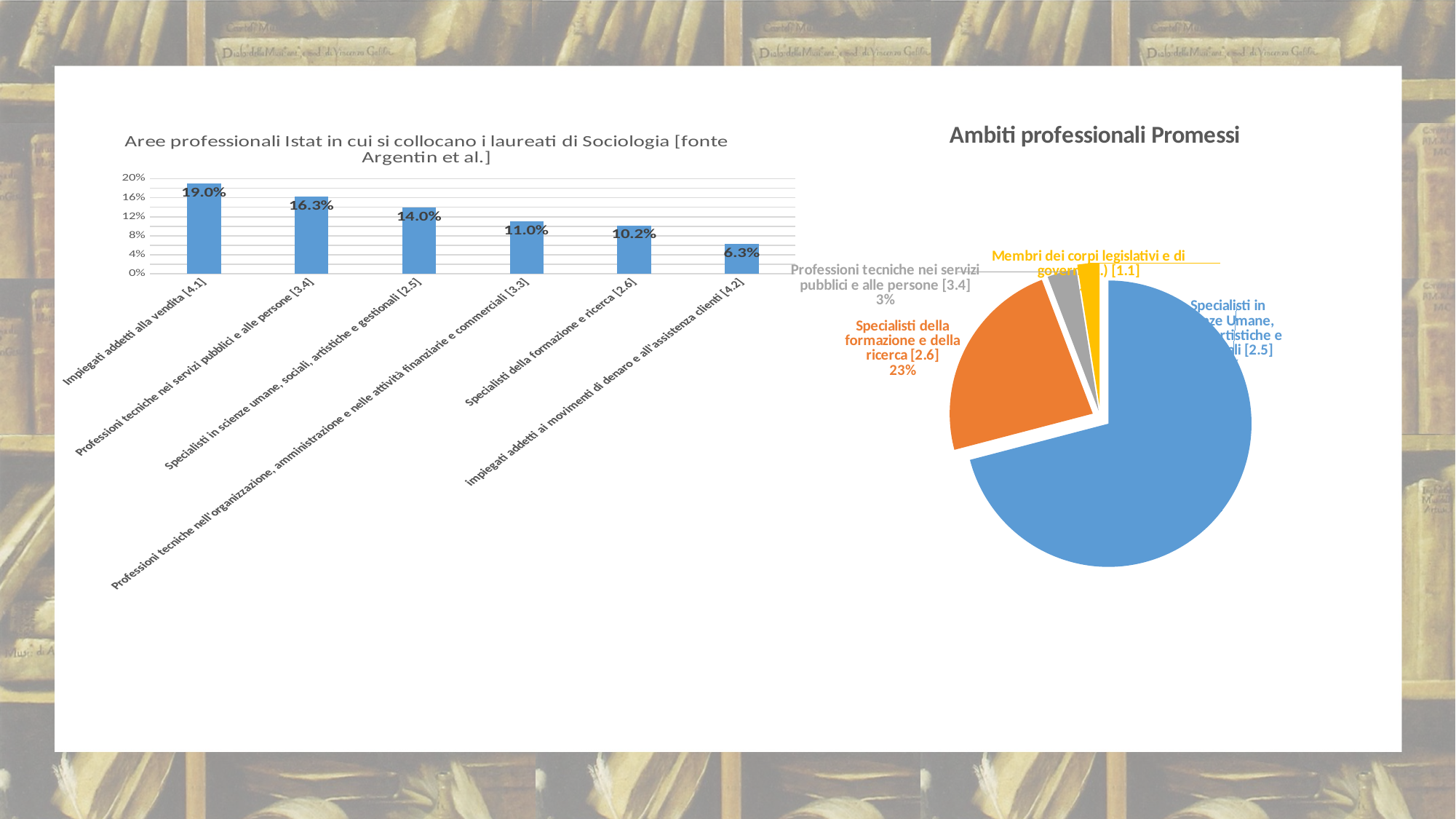
In the bar chart on the left, which is larger: the value for Professioni tecniche nell'organizzazione, amministrazione e nelle attività finanziarie e commerciali [3.3] or the value for Specialisti della formazione e ricerca [2.6]? Professioni tecniche nell'organizzazione, amministrazione e nelle attività finanziarie e commerciali [3.3] In the bar chart on the left, what is the value for Impiegati addetti alla vendita [4.1]? 19.0% In the bar chart on the left, what is the difference between the values for Impiegati addetti alla vendita [4.1] and Professioni tecniche nei servizi pubblici e alle persone [3.4]? 2.7% How many categories are shown in the bar chart on the left? 6 In the bar chart on the left, what is the value for Specialisti in scienze umane, sociali, artistiche e gestionali [2.5]? 14.0% In the bar chart on the left, which category has the highest value? Impiegati addetti alla vendita [4.1] In the pie chart 'Ambiti professionali Promessi', what share does Specialisti della formazione e della ricerca [2.6] have? 23% In the bar chart on the left, what is the value for Specialisti della formazione e ricerca [2.6]? 10.2% In the pie chart 'Ambiti professionali Promessi', what share does Professioni tecniche nei servizi pubblici e alle persone [3.4] have? 3% What kind of chart is the chart titled 'Ambiti professionali Promessi'? pie chart In the bar chart on the left, which category has the lowest value? impiegati addetti ai movimenti di denaro e all'assistenza clienti [4.2] Do the values in the bar chart on the left rise or fall from left to right? fall